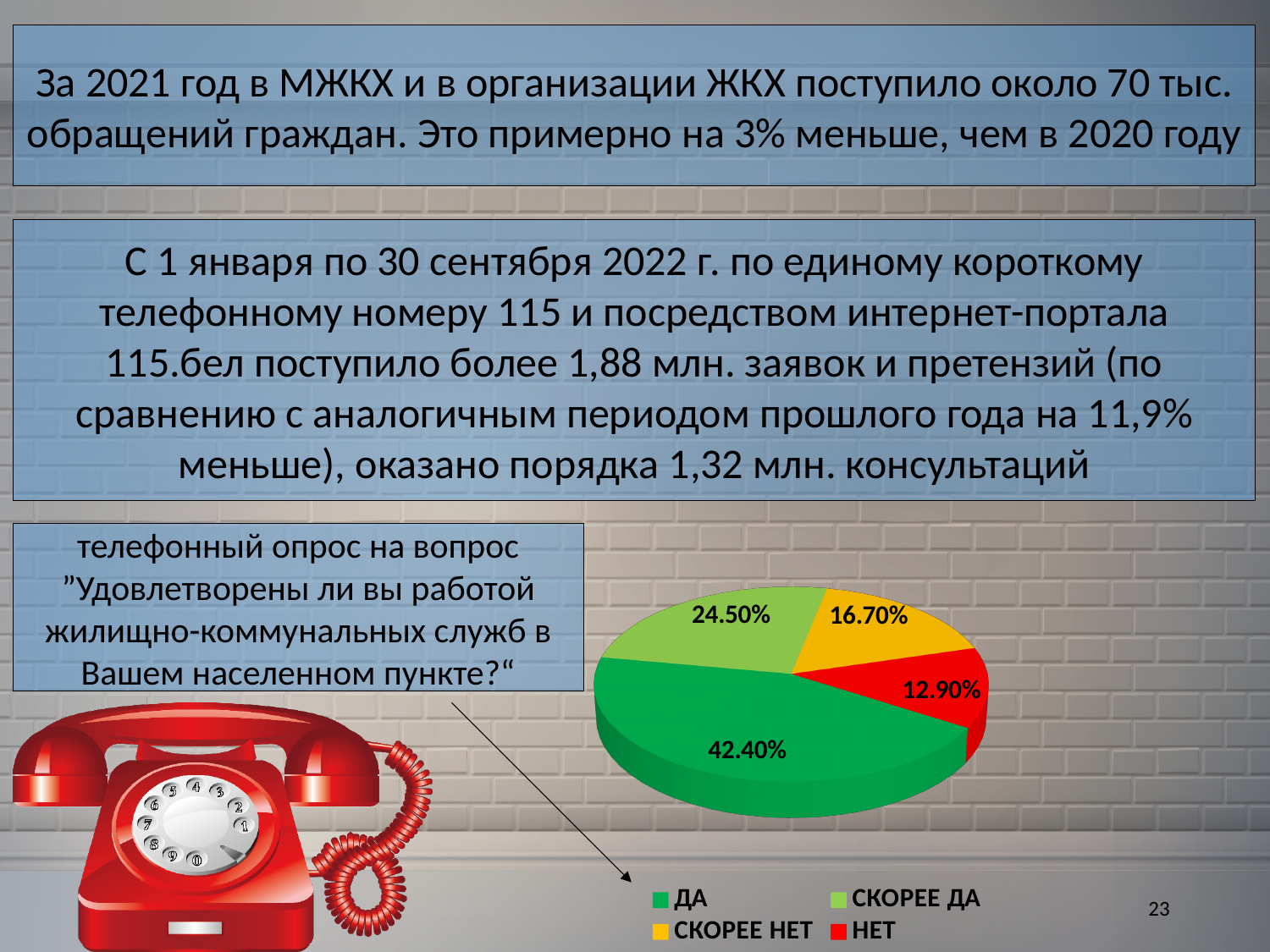
What share of respondents answered "НЕТ" in the pie chart? 12.90% What kind of chart is shown on the slide? pie chart How many slices does the pie chart have? 4 Which answer has the largest slice in the pie chart? ДА Which slice is larger in the pie chart: "СКОРЕЕ ДА" or "СКОРЕЕ НЕТ"? СКОРЕЕ ДА What share of respondents answered "ДА" in the pie chart? 42.40% How many entries does the legend of the pie chart list? 4 What share of respondents answered "СКОРЕЕ ДА" in the pie chart? 24.50% What is the difference in percentage points between the "ДА" and "НЕТ" slices? 29.50% What share of respondents answered "СКОРЕЕ НЕТ" in the pie chart? 16.70% What colour is the "НЕТ" slice in the pie chart? red Which answer has the smallest slice in the pie chart? НЕТ